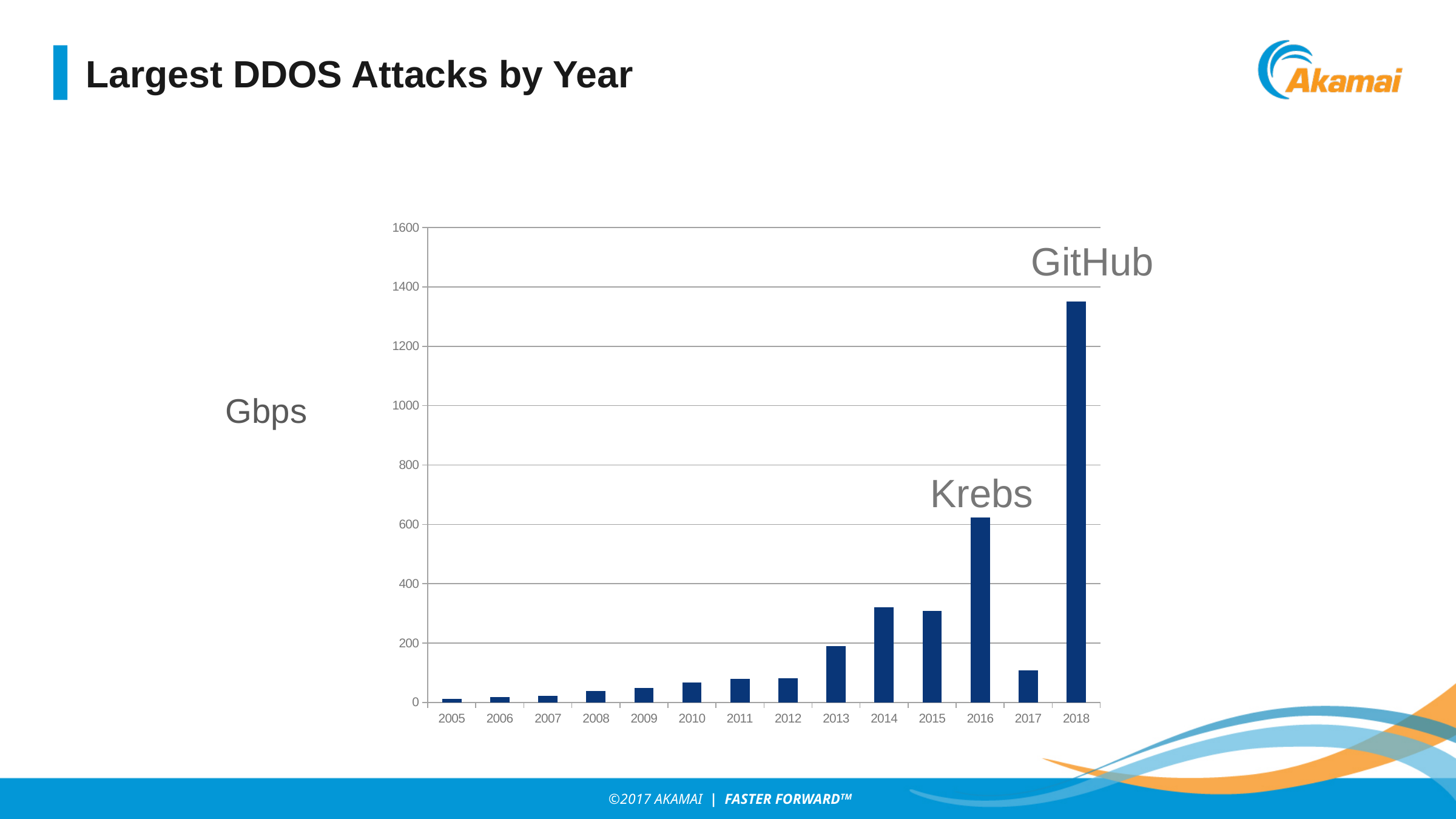
Do the values generally rise or fall from 2005 to 2018? rise What kind of chart is shown on the slide? bar chart Which year has the lowest value in the chart? 2005 Is the value for 2018 greater or less than 1200? greater How many years are shown on the x axis of the chart? 14 Which year has the highest value in the chart? 2018 Which year has the larger value, 2016 or 2017? 2016 Is the value for 2014 greater or less than 200? greater Which attack name is annotated above the 2016 bar? Krebs Which year has the larger value, 2013 or 2014? 2014 Is the value for 2016 greater or less than 400? greater